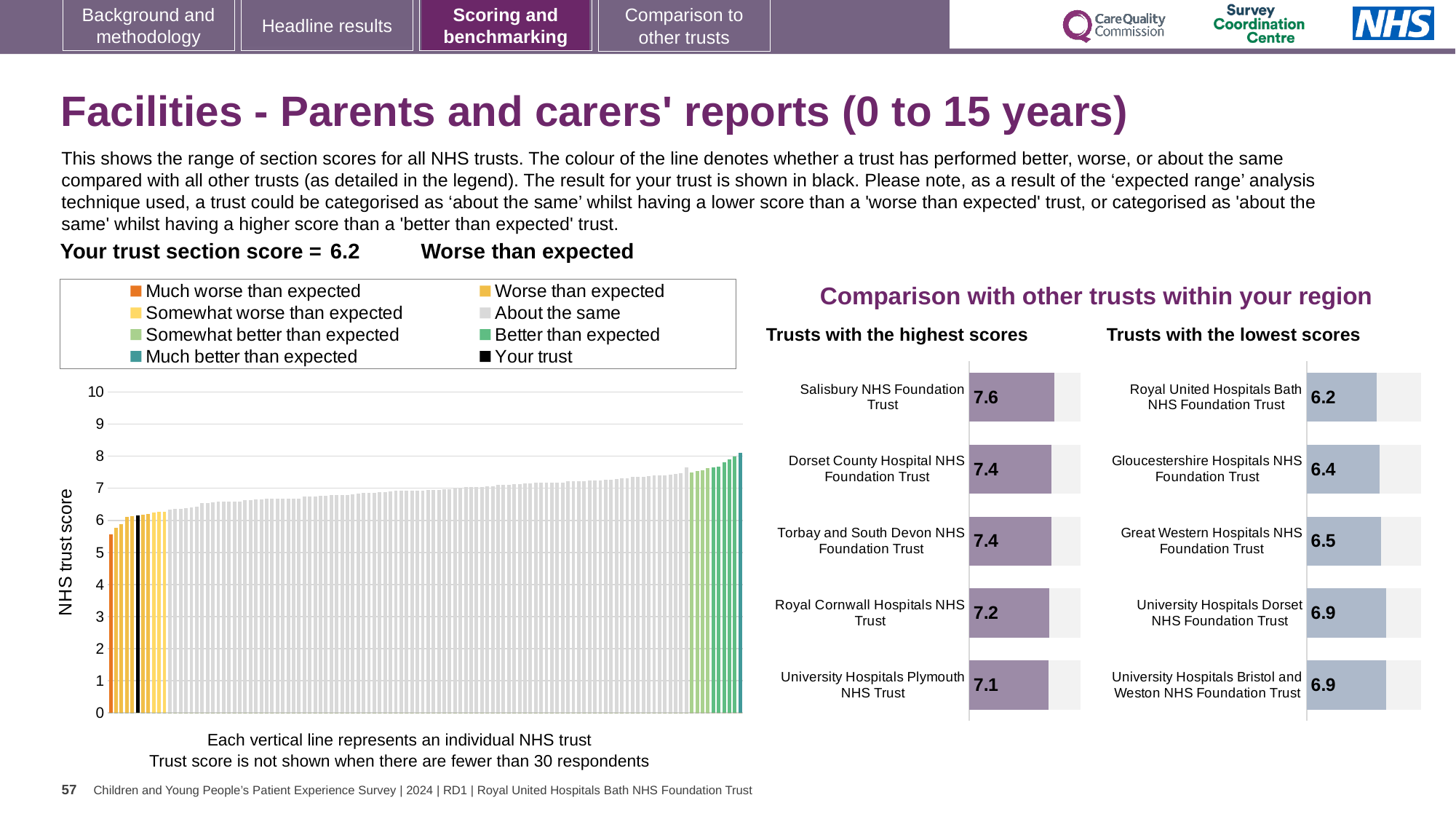
How many trusts are shown in the 'Trusts with the highest scores' chart? 5 What kind of chart is the large chart on the left showing NHS trust scores? Bar chart In the 'Trusts with the highest scores' chart, what is the score for Salisbury NHS Foundation Trust? 7.6 In the 'Trusts with the lowest scores' chart, which trust has the lowest score? Royal United Hospitals Bath NHS Foundation Trust In the left-hand chart of NHS trust scores, do the bars rise or fall from left to right? Rise In the 'Trusts with the lowest scores' chart, what is the score for Gloucestershire Hospitals NHS Foundation Trust? 6.4 What is the label on the vertical axis of the left-hand chart? NHS trust score In the left-hand chart, is the value for the black 'Your trust' bar greater or less than 7? less How many entries does the legend above the left-hand chart list? 8 In the 'Trusts with the lowest scores' chart, which has the larger score: Great Western Hospitals NHS Foundation Trust or University Hospitals Dorset NHS Foundation Trust? University Hospitals Dorset NHS Foundation Trust In the 'Trusts with the highest scores' chart, what is the difference between the scores of Salisbury NHS Foundation Trust and University Hospitals Plymouth NHS Trust? 0.5 In the 'Trusts with the highest scores' chart, which trust has the highest score? Salisbury NHS Foundation Trust